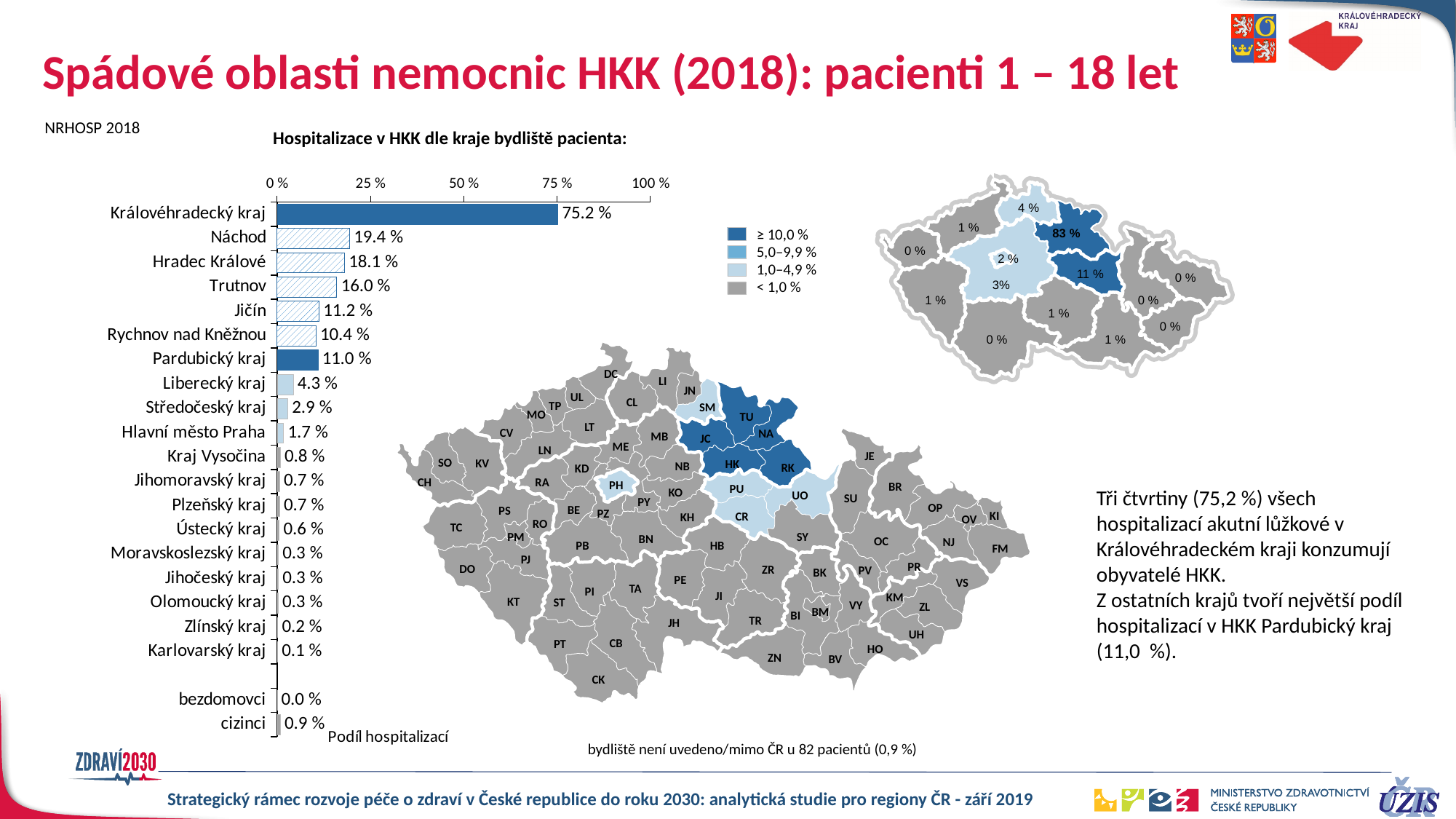
What type of chart is used for 'Hospitalizace v HKK dle kraje bydliště pacienta'? bar chart How many entries does the legend of the map in the upper right list? 4 Which category has the highest value in the bar chart? Královéhradecký kraj In the bar chart, what is the difference between the values for Náchod and Hradec Králové? 1.3 % In the bar chart, what is the value for Trutnov? 16.0 % In the bar chart, what is the value for Pardubický kraj? 11.0 % Which category has the lowest value in the bar chart? bezdomovci In the bar chart, what is the value for cizinci? 0.9 % In the bar chart, what is the value for Královéhradecký kraj? 75.2 % In the bar chart, is the value for Královéhradecký kraj greater or less than 50 %? greater In the bar chart, which is larger: the value for Pardubický kraj or Liberecký kraj? Pardubický kraj How many categories are listed in the bar chart? 21